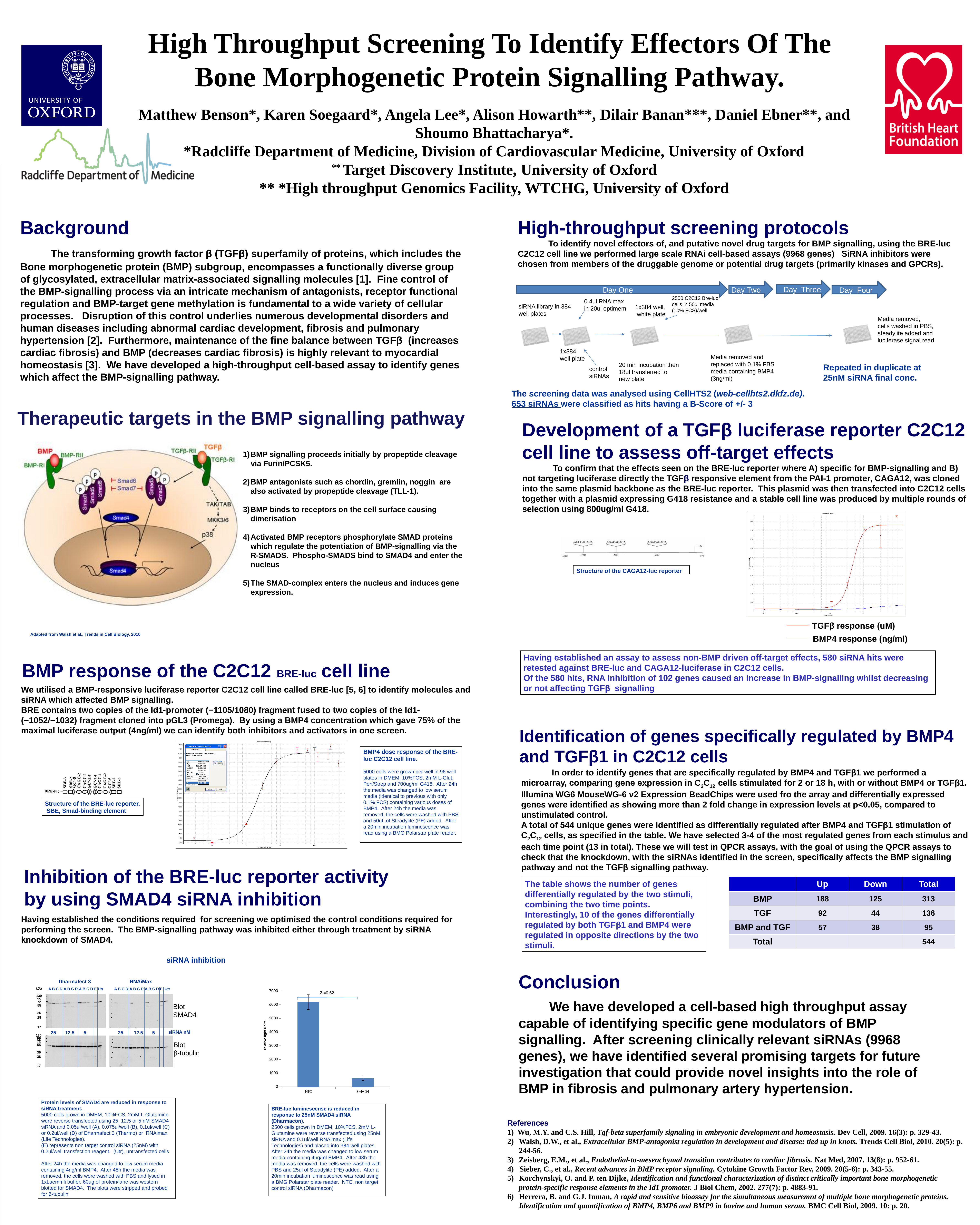
In the siRNA inhibition bar chart, what kind of chart is shown? bar chart In the siRNA inhibition bar chart, what Z' value is printed above the bars? Z'=0.62 In the TGFβ luciferase reporter chart (CAGA12-luc), how many series does the legend list? 2 In the siRNA inhibition bar chart, which category has the highest value? NTC In the siRNA inhibition bar chart, how many categories are plotted on the x axis? 2 In the siRNA inhibition bar chart, is the value for NTC greater or less than 5000? greater In the TGFβ luciferase reporter chart (CAGA12-luc), which series is shown in red? TGFβ response (uM) In the siRNA inhibition bar chart, is the value for SMAD4 greater or less than 1000? less In the siRNA inhibition bar chart, which category has the lowest value? SMAD4 In the siRNA inhibition bar chart, which is larger, the value for NTC or the value for SMAD4? NTC In the siRNA inhibition bar chart, what is the label of the y axis? relative light units